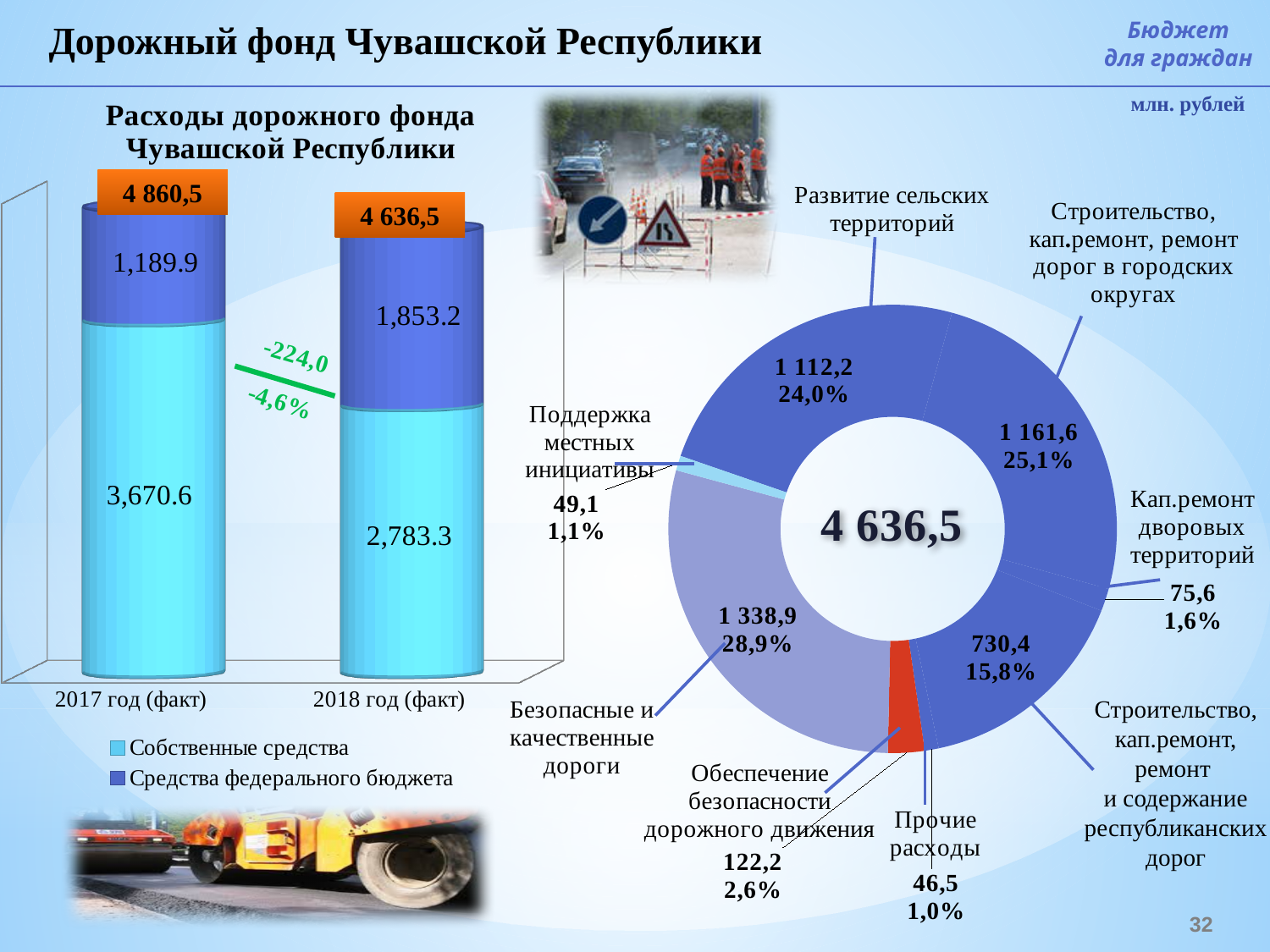
On the bar chart 'Расходы дорожного фонда Чувашской Республики', which year has the larger value for 'Средства федерального бюджета'? 2018 год (факт) On the bar chart 'Расходы дорожного фонда Чувашской Республики', what is the value of 'Собственные средства' for 2017 год (факт)? 3,670.6 On the bar chart 'Расходы дорожного фонда Чувашской Республики', what is the total for 2017 год (факт)? 4 860,5 On the bar chart 'Расходы дорожного фонда Чувашской Республики', how many series does the legend list? 2 On the donut chart on the right, which category has the smallest value? Прочие расходы On the bar chart 'Расходы дорожного фонда Чувашской Республики', what is the value of 'Средства федерального бюджета' for 2018 год (факт)? 1,853.2 On the donut chart on the right, what is the value for 'Безопасные и качественные дороги'? 1 338,9 On the donut chart on the right, how many categories are shown? 8 On the donut chart on the right, what share does 'Развитие сельских территорий' have? 24,0% What kind of chart is shown on the right side of the slide? Donut (pie) chart On the bar chart 'Расходы дорожного фонда Чувашской Республики', what change in total from 2017 to 2018 is shown in green? -224,0 (-4,6%) On the bar chart 'Расходы дорожного фонда Чувашской Республики', what is the total for 2018 год (факт)? 4 636,5